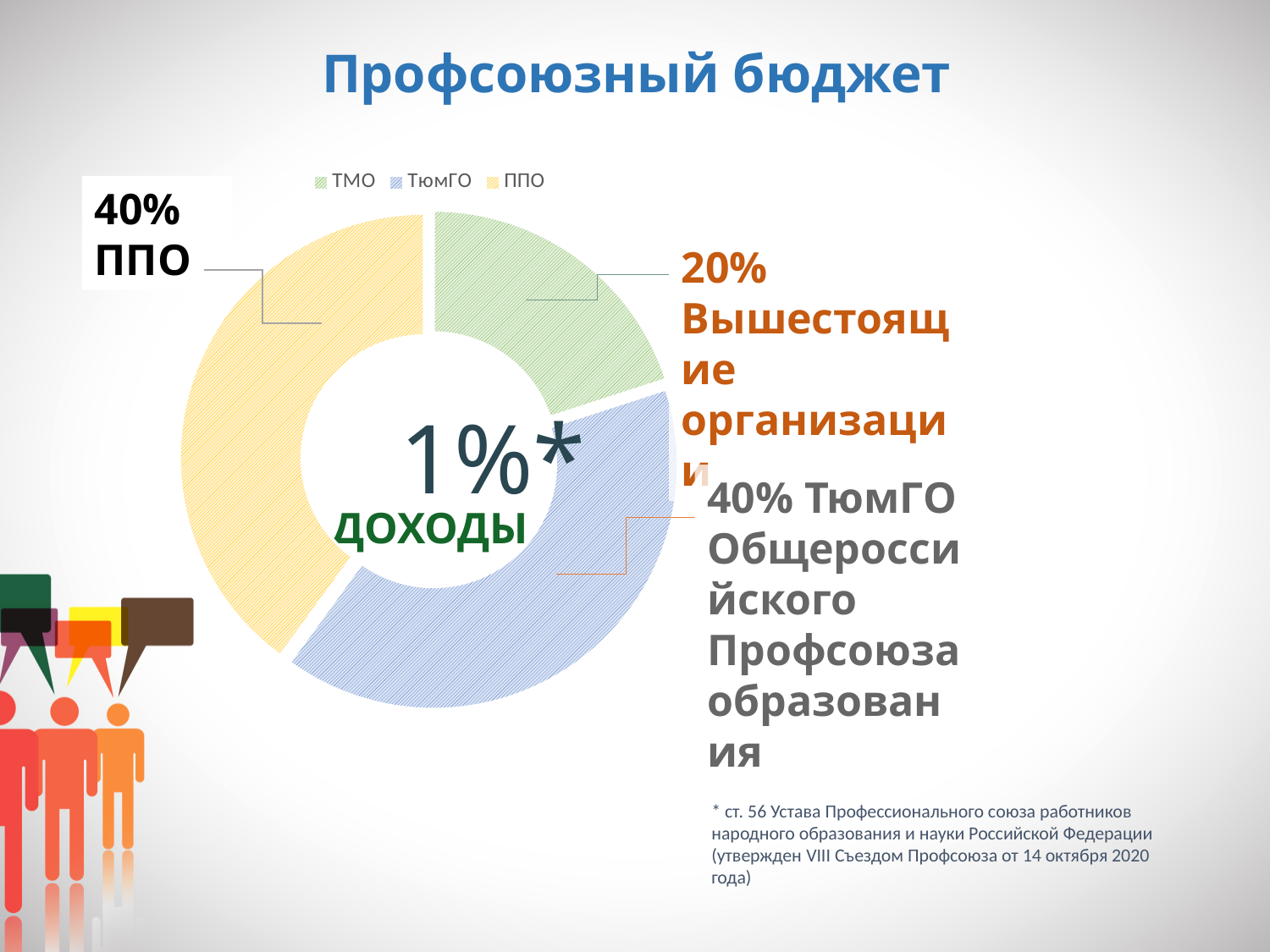
What share of the chart does ТюмГО account for? 40% Which category has the smallest share of the chart? ТМО Is the share for ТюмГО greater or less than 30%? greater What share of the chart does ППО account for? 40% Is the share for ТМО greater or less than 30%? less How many categories does the chart's legend list? 3 Which is larger, the share for ППО or the share for ТМО? ППО What is the difference between the ППО share and the ТМО share? 20% What kind of chart is shown on the slide? doughnut chart What percentage is shown for the Вышестоящие организации (ТМО) slice? 20% What text is shown in the centre of the doughnut chart? 1%* ДОХОДЫ What is the title of the slide containing the chart? Профсоюзный бюджет